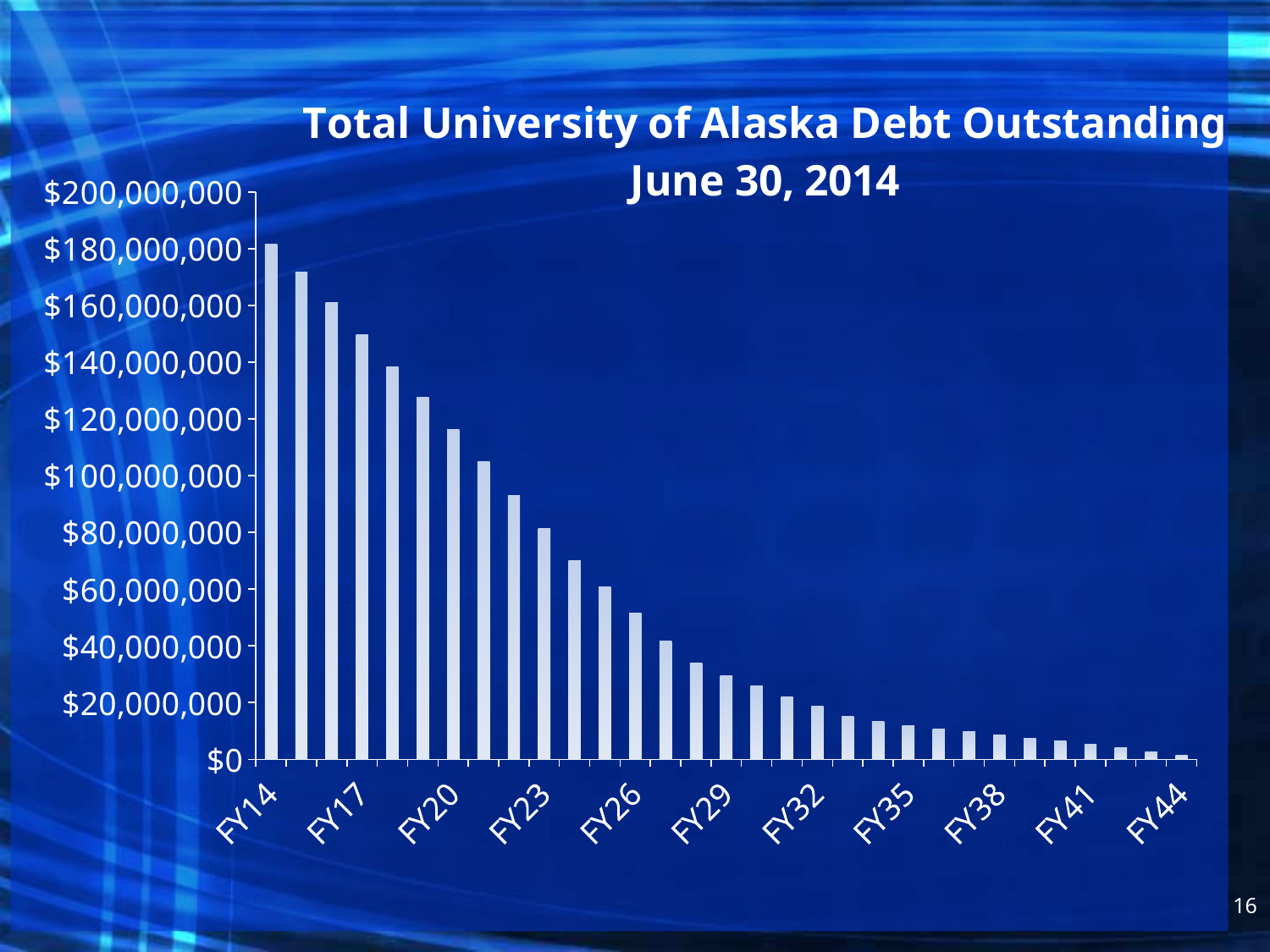
Is the value for FY17 greater or less than $140,000,000? greater Which fiscal year has the highest debt outstanding? FY14 Which is larger, the value for FY20 or the value for FY29? FY20 Is the value for FY20 greater or less than $100,000,000? greater Is the value for FY26 greater or less than $40,000,000? greater What is the title of the chart? Total University of Alaska Debt Outstanding June 30, 2014 Do the values rise or fall from FY14 to FY44? Fall What kind of chart is shown on the slide? Bar chart Which fiscal year has the lowest debt outstanding? FY44